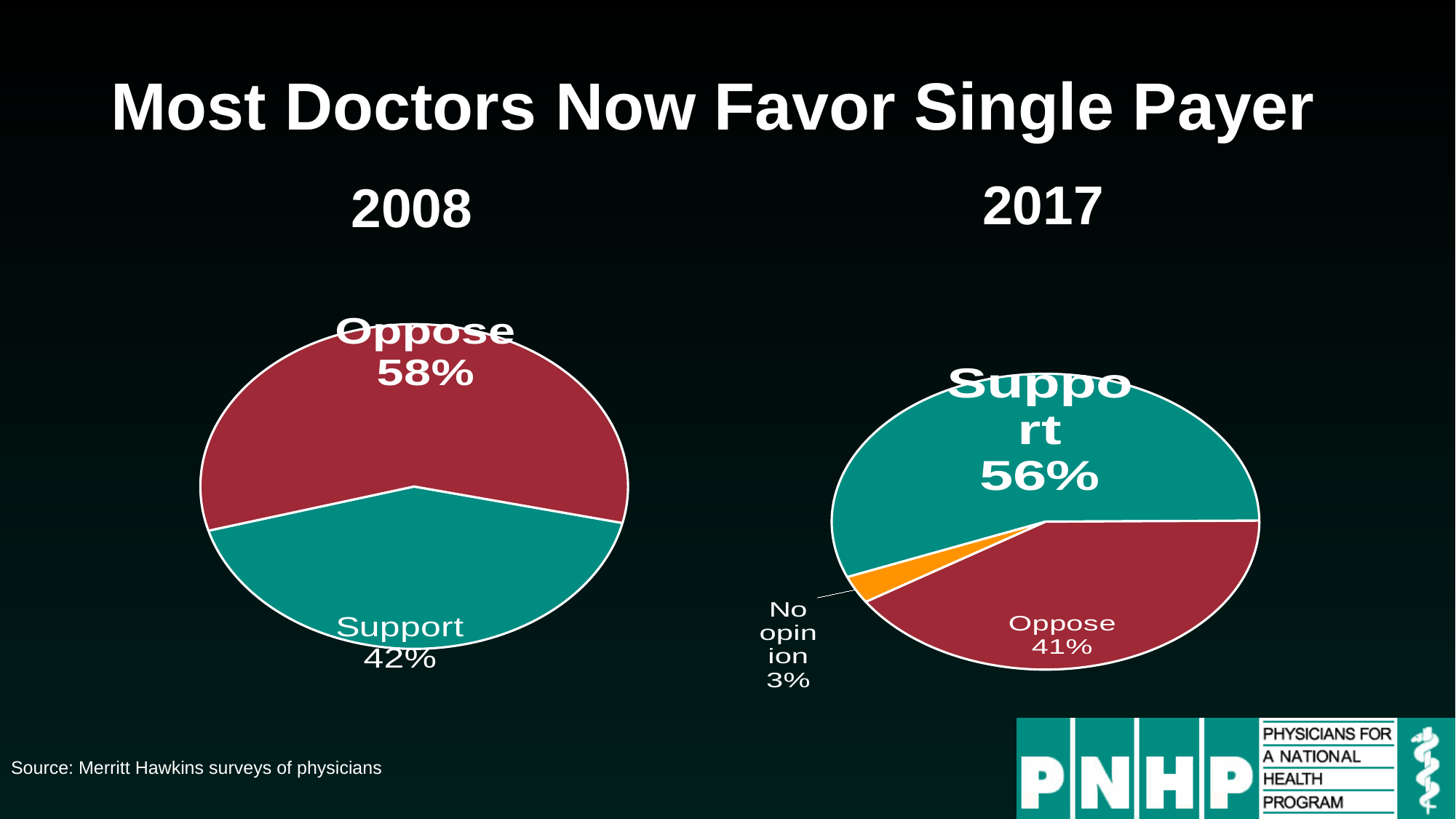
In the 2008 pie chart, what percentage of doctors opposed single payer? 58% In the 2008 pie chart, what percentage of doctors supported single payer? 42% In the 2017 pie chart, which is larger, Support or Oppose? Support In the 2008 pie chart, what is the difference between the Oppose and Support percentages? 16% How many slices does the 2017 pie chart have? 3 What type of chart is used for the 2008 data? Pie chart What is the title of the slide containing the two pie charts? Most Doctors Now Favor Single Payer In the 2017 pie chart, what percentage of doctors opposed single payer? 41% In the 2008 pie chart, which slice is the largest? Oppose In the 2017 pie chart, what share of doctors had no opinion? 3% In the 2017 pie chart, what percentage of doctors supported single payer? 56% In the 2017 pie chart, which slice is the smallest? No opinion